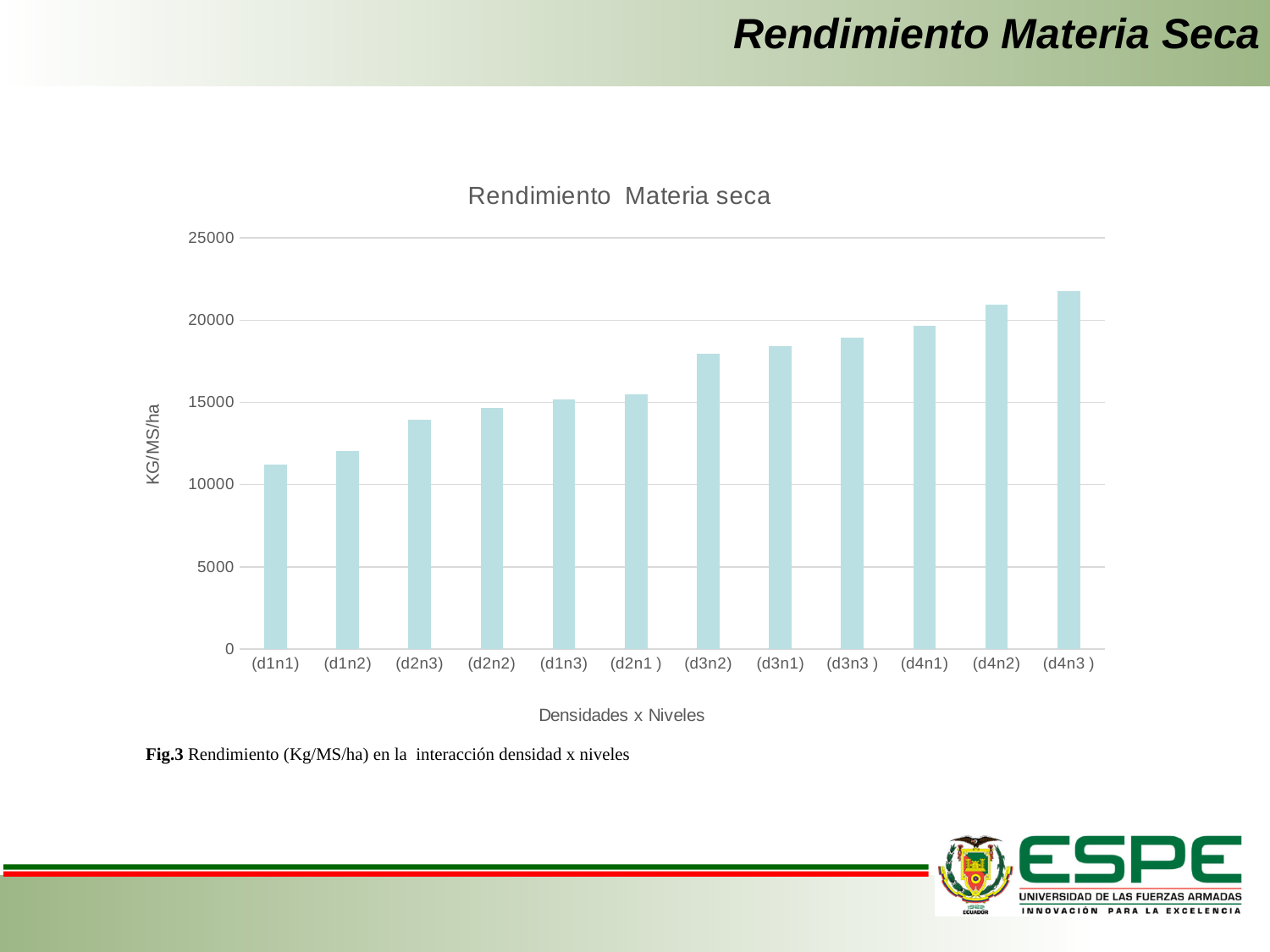
Is the value for (d4n3 ) greater or less than 20000? greater What is the label on the vertical axis of the chart? KG/MS/ha Is the value for (d4n1) greater or less than 15000? greater Which category has the highest value in the chart? (d4n3 ) How many categories are plotted along the x axis of the chart? 12 What type of chart is shown on the slide? bar chart Is the value for (d2n3) greater or less than 15000? less Which is larger, the value for (d4n2) or the value for (d1n2)? (d4n2) Do the values generally rise or fall from left to right along the x axis? rise Which category has the lowest value in the chart? (d1n1)